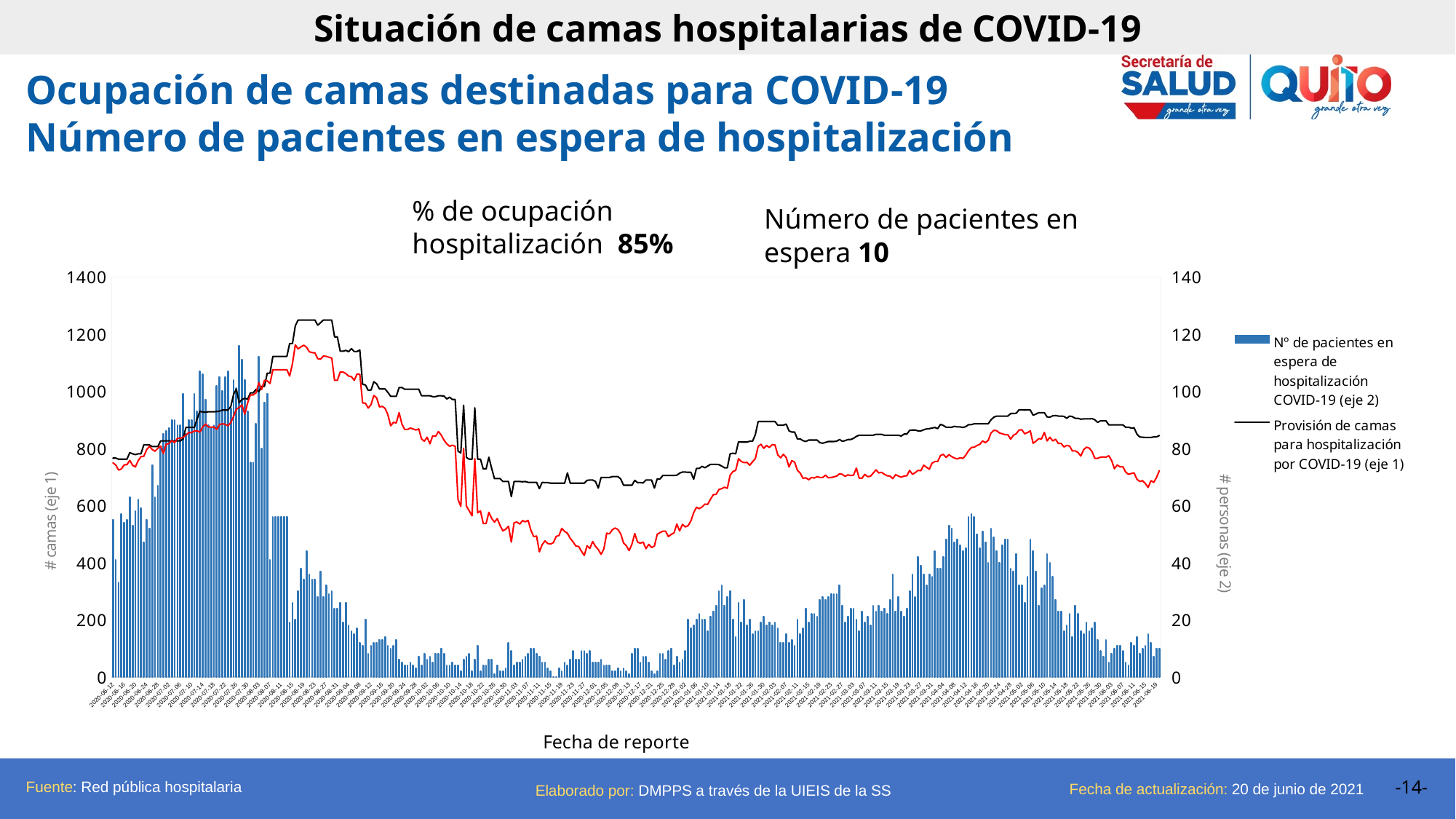
What is the label of the left vertical axis (eje 1)? # camas (eje 1) Is the value of the black line 'Provisión de camas para hospitalización por COVID-19 (eje 1)' around 2020-11-11 greater or less than 800? less What kind of chart is shown on the slide? A combination chart with bars and lines Is the highest blue bar for 'Nº de pacientes en espera de hospitalización COVID-19 (eje 2)' around late July 2020 greater or less than 100 on the right axis? greater Are the blue bars for 'Nº de pacientes en espera de hospitalización COVID-19 (eje 2)' around 2020-12-05 greater or less than 20 on the right axis? less Does the black line 'Provisión de camas para hospitalización por COVID-19 (eje 1)' rise or fall between 2020-08-27 and 2020-11-11? fall How many series does the chart legend list? 2 According to the text above the chart, what is the percentage of hospitalization occupancy? 85% What is the title of the horizontal axis of the chart? Fecha de reporte Does the red line rise or fall between 2021-01-02 and 2021-01-30? rise